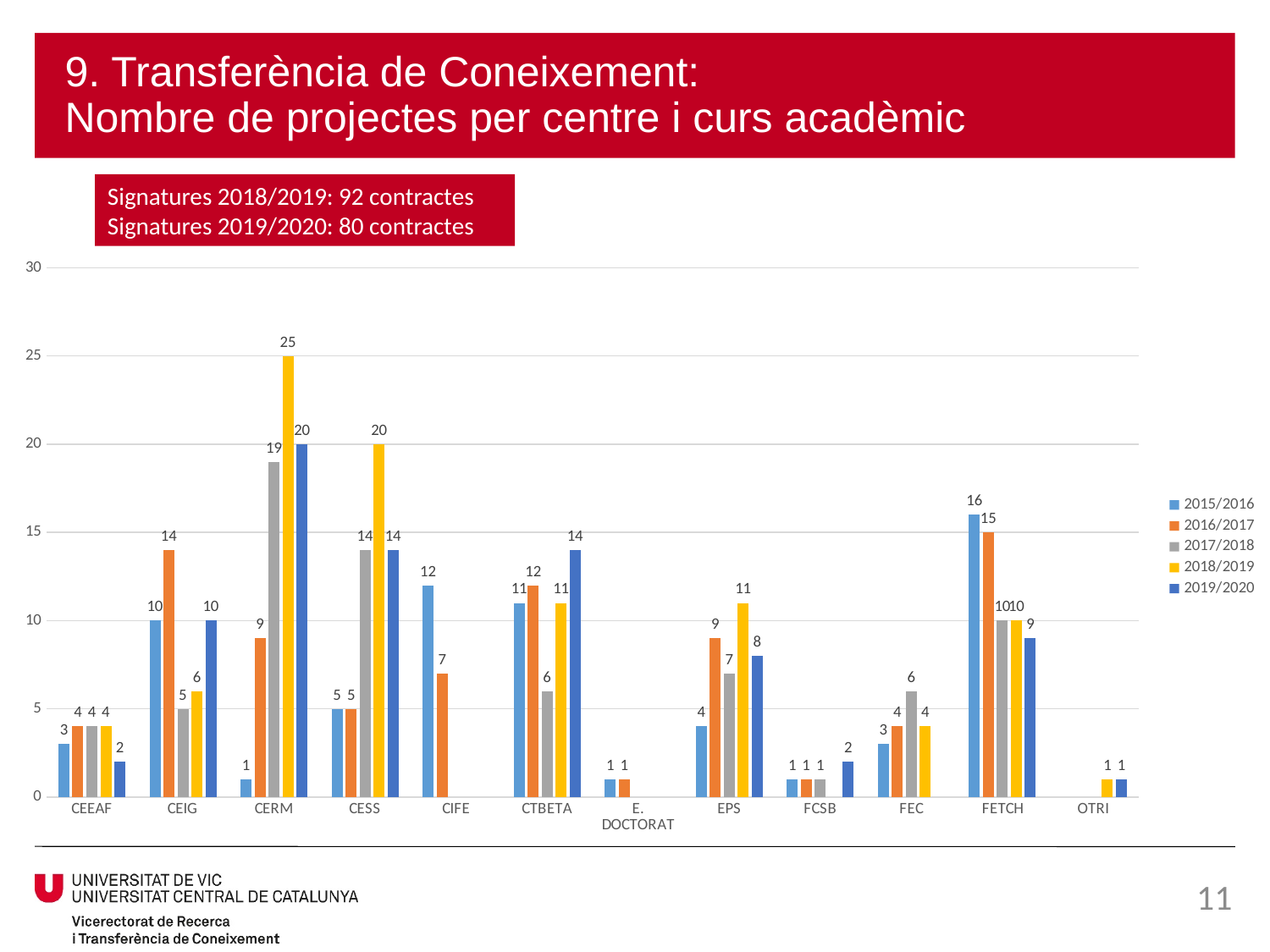
What is the difference between the 2018/2019 and 2019/2020 values for CERM? 5 Which centre has the highest value in 2015/2016? FETCH Which series is shown in yellow in the legend? 2018/2019 Which is larger for CEIG: the 2016/2017 value or the 2017/2018 value? 2016/2017 Which centre has the highest value in 2018/2019? CERM What type of chart is shown on the slide? bar chart How many series does the legend list? 5 Is the value for CESS in 2018/2019 greater or less than 15? greater How many centres (categories) are shown on the x axis? 12 What is the value for CTBETA in 2019/2020? 14 What is the value for CERM in 2018/2019? 25 What is the value for FETCH in 2015/2016? 16